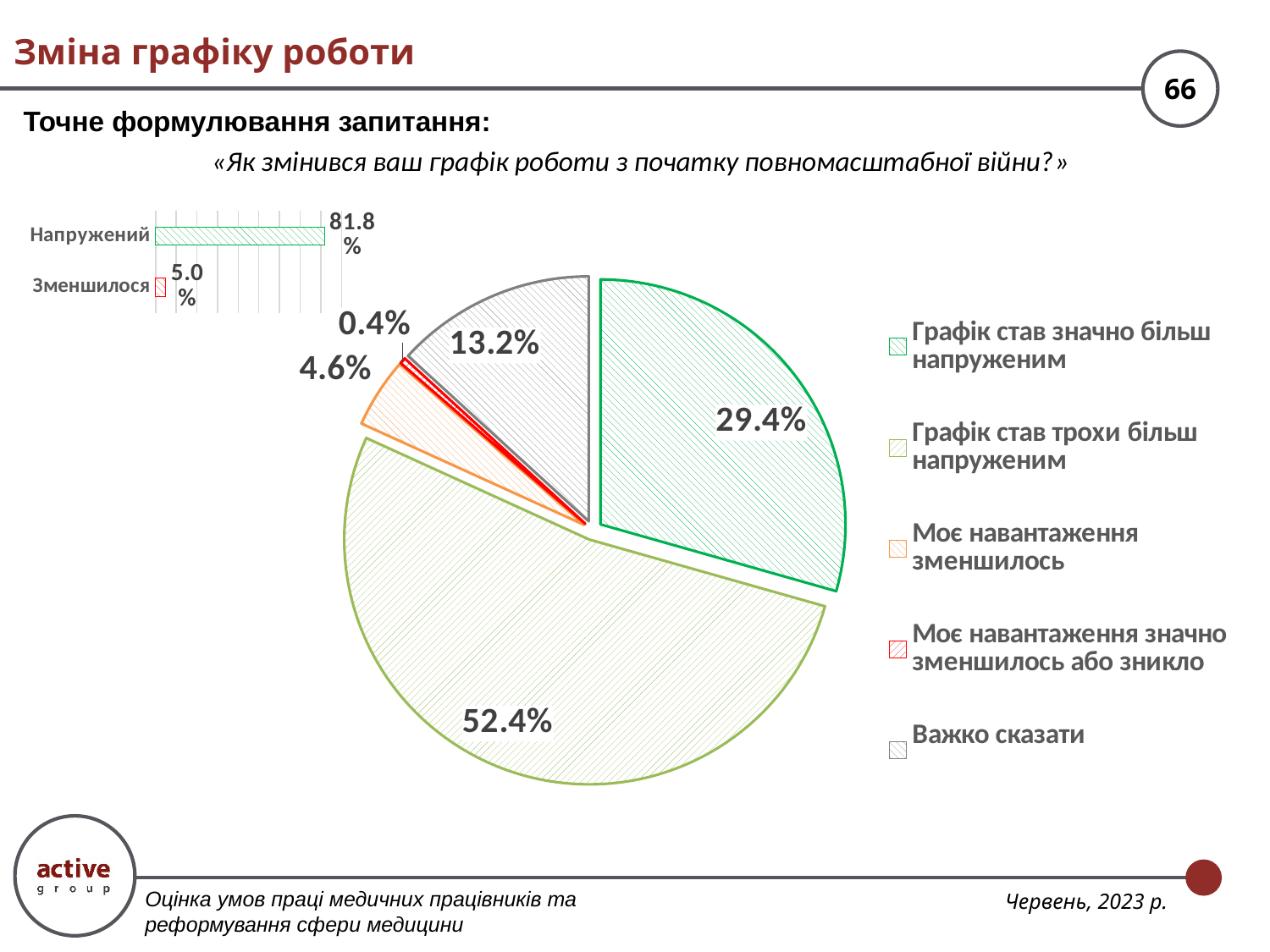
How many slices does the pie chart have? 5 In the small bar chart at the top left, what is the value for 'Напружений'? 81.8% In the pie chart, which category has the largest share? Графік став трохи більш напруженим In the pie chart, what is the difference between the shares for 'Графік став трохи більш напруженим' and 'Графік став значно більш напруженим'? 23.0 percentage points In the pie chart, what share of respondents said their workload decreased (Моє навантаження зменшилось)? 4.6% In the pie chart, what share of respondents said their schedule became slightly more intense (Графік став трохи більш напруженим)? 52.4% In the pie chart, what share of respondents answered 'Важко сказати'? 13.2% In the small bar chart at the top left, what is the value for 'Зменшилося'? 5.0% In the pie chart, which category has the smallest share? Моє навантаження значно зменшилось або зникло What type of chart is the large chart in the centre of the slide? Pie chart In the pie chart, which is larger: the share for 'Важко сказати' or the share for 'Моє навантаження зменшилось'? Важко сказати In the pie chart, what share of respondents said their schedule became significantly more intense (Графік став значно більш напруженим)? 29.4%